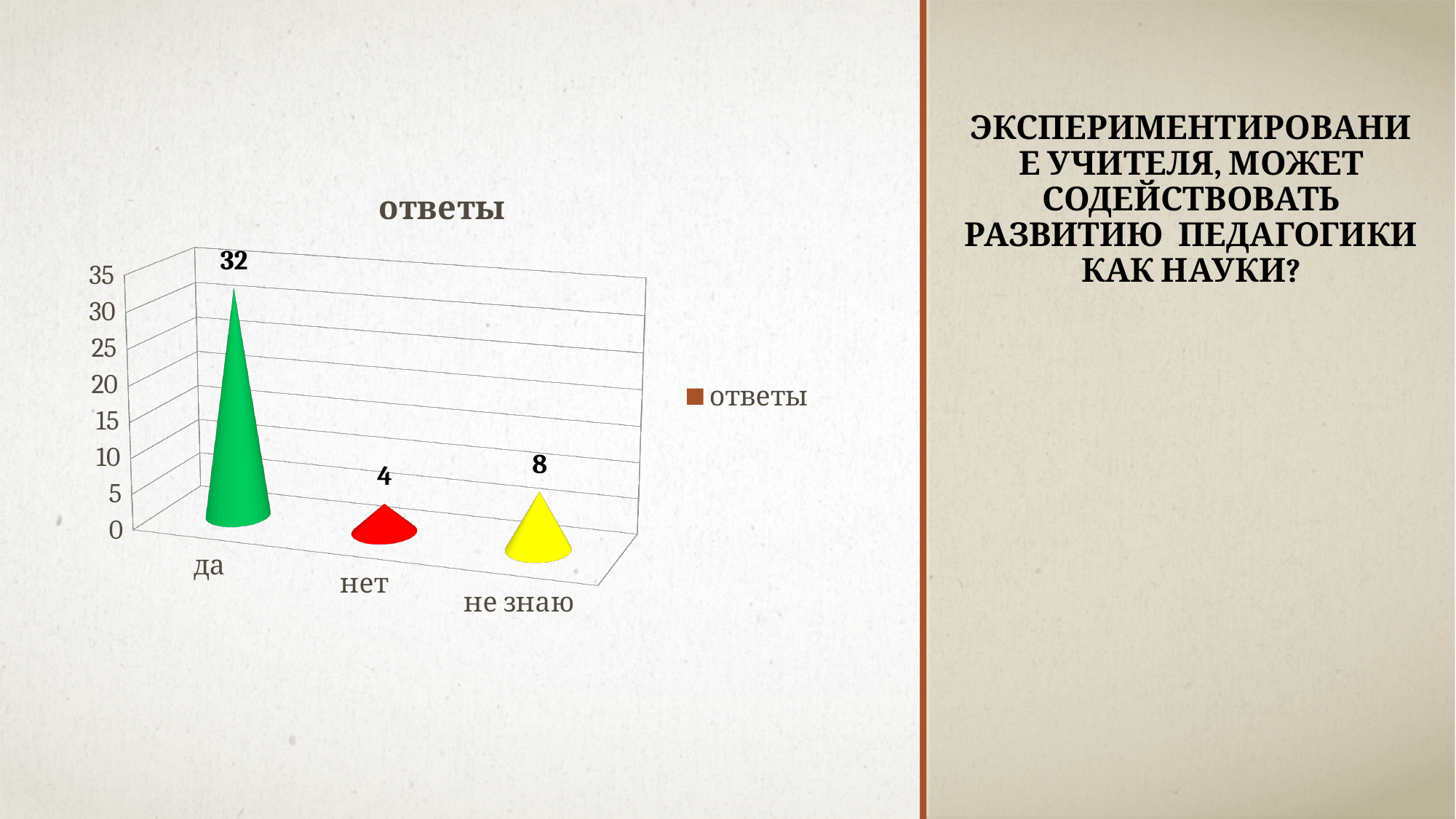
Which category has the lowest value? нет How many series does the legend list? 1 What is the value for "не знаю"? 8 What is the difference between the values for "да" and "не знаю"? 24 What is the title of the chart? ответы What is the difference between the values for "не знаю" and "нет"? 4 Which category has the highest value? да Is the value for "да" greater or less than 30? greater What is the value for "нет"? 4 What is the value for "да"? 32 How many categories are shown on the x axis? 3 Which is larger, the value for "нет" or the value for "не знаю"? не знаю